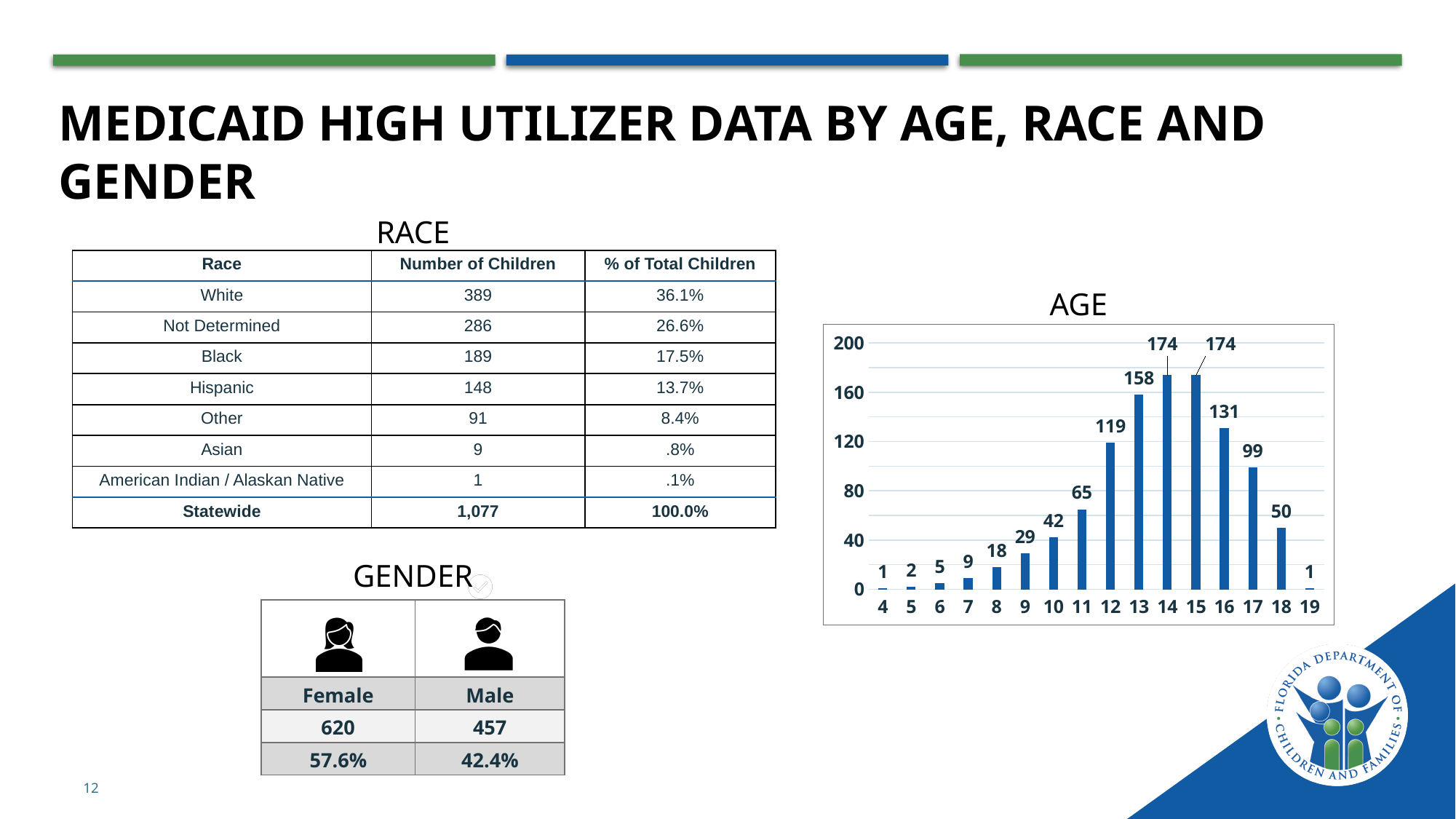
In the AGE chart, which is larger, the value for age 11 or the value for age 18? Age 11 How many age categories are plotted in the AGE chart? 16 In the AGE chart, what is the difference between the values for age 13 and age 16? 27 In the AGE chart, is the value for age 16 greater or less than 120? greater In the AGE chart, what is the value for age 8? 18 What kind of chart is the AGE chart? Bar chart In the AGE chart, which two ages share the highest value? 14 and 15 In the AGE chart, do the values rise or fall from age 4 to age 14? Rise In the AGE chart, what is the highest value shown? 174 In the AGE chart, what is the lowest value shown? 1 In the AGE chart, what is the value for age 12? 119 In the AGE chart, what is the value for age 17? 99